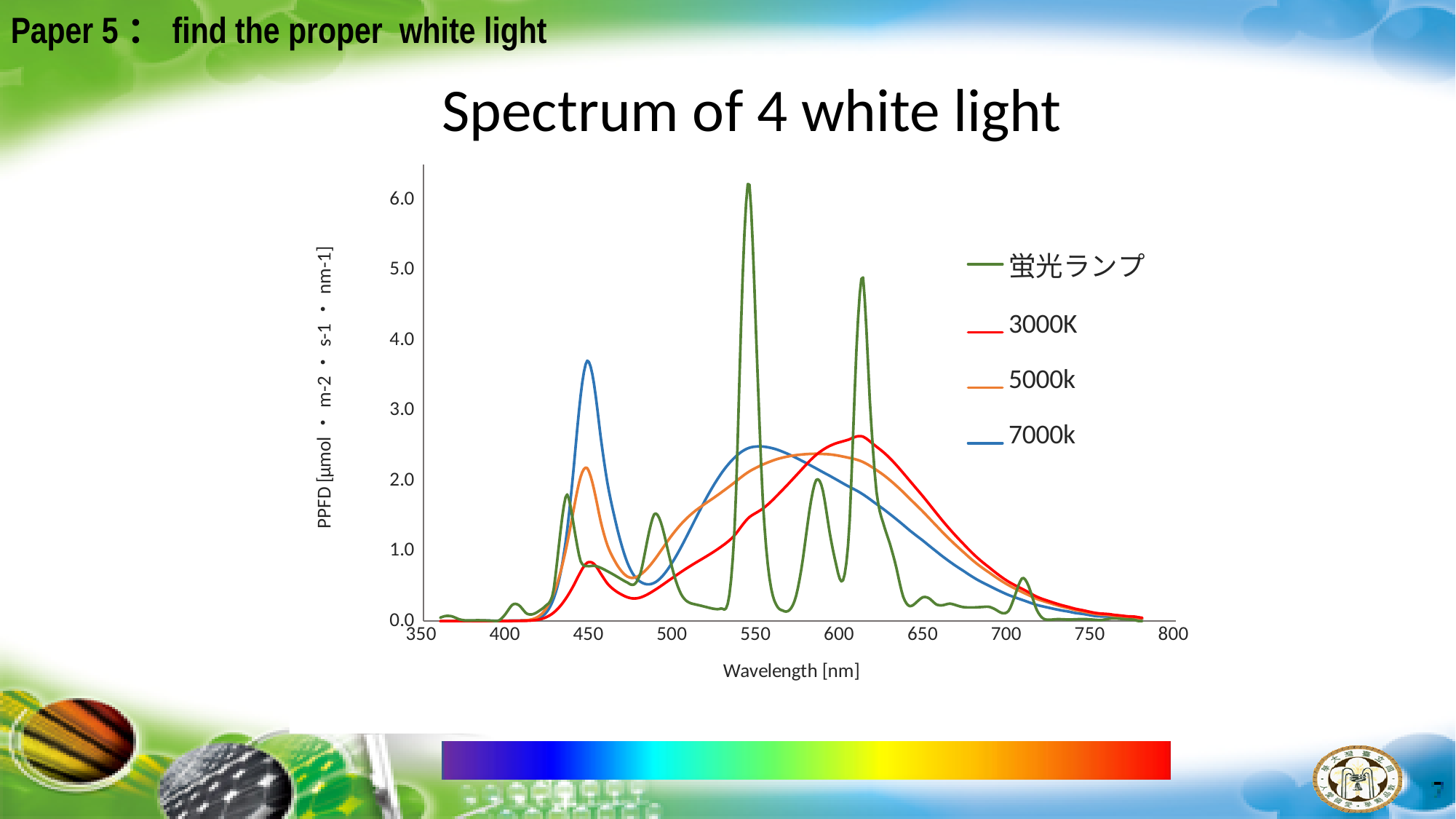
Is the peak of the 7000k series near 450 nm greater or less than 3.0? greater Which series reaches the highest value on the chart? 蛍光ランプ What is the title of the chart? Spectrum of 4 white light At 650 nm, which series is higher, 3000K or 7000k? 3000K What is the label of the x axis? Wavelength [nm] How many series does the legend list? 4 Is the peak of the 3000K series near 615 nm greater or less than 2.0? greater Is the highest peak of the 蛍光ランプ series greater or less than 5.0? greater At 450 nm, which series is higher, 7000k or 5000k? 7000k What kind of chart is shown on the slide? line chart